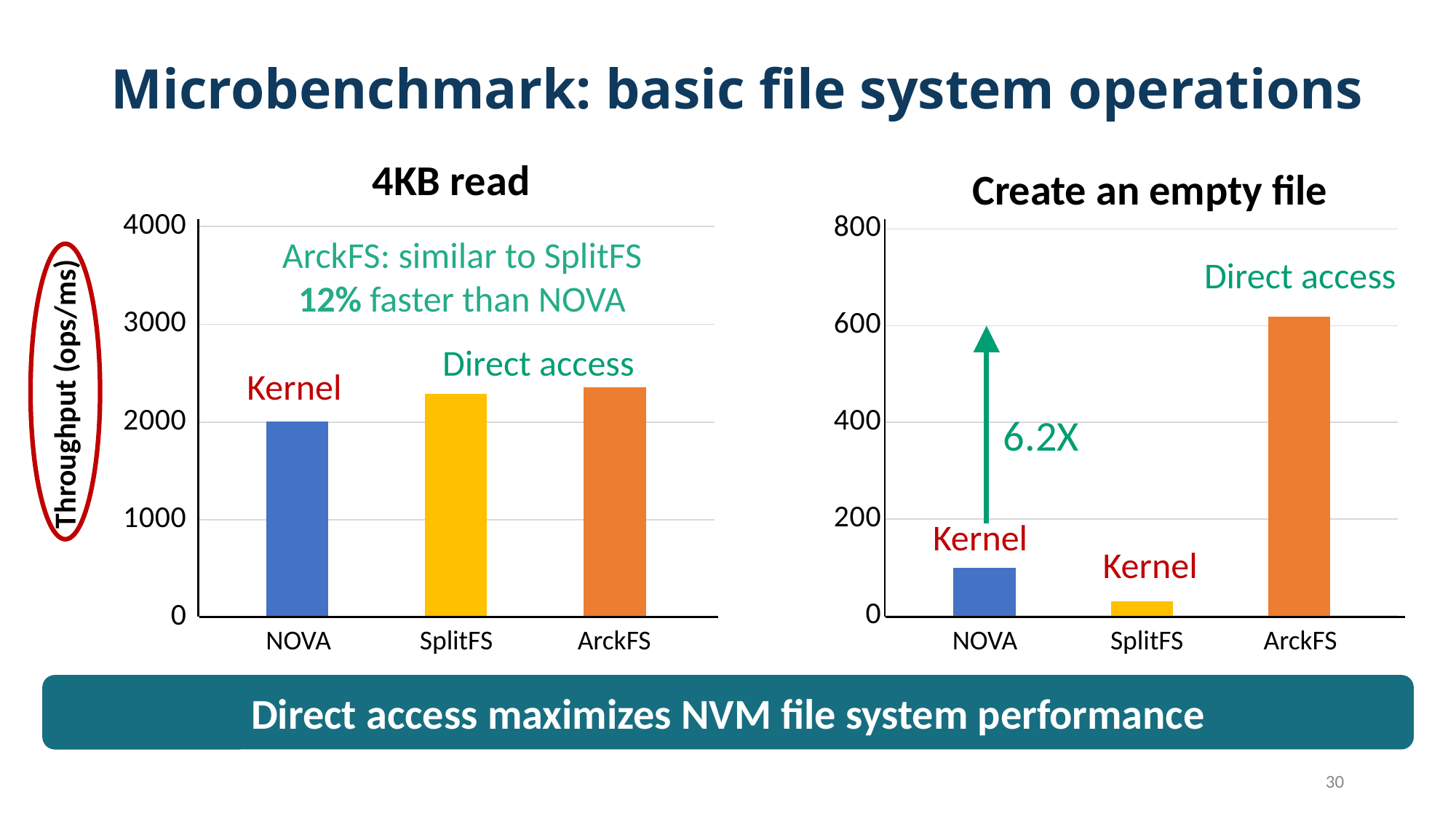
In the "Create an empty file" chart, which file system has the highest throughput? ArckFS In the "Create an empty file" chart, which is larger, the value for NOVA or the value for SplitFS? NOVA In the "4KB read" chart, is the value for SplitFS greater or less than 2000? greater In the "Create an empty file" chart, which file system has the lowest throughput? SplitFS In the "4KB read" chart, which is larger, the value for NOVA or the value for SplitFS? SplitFS What is the y-axis label shared by the two charts? Throughput (ops/ms) In the "Create an empty file" chart, is the value for ArckFS greater or less than 400? greater In the "4KB read" chart, is the value for ArckFS greater or less than 3000? less How many file systems are shown on the x axis of the "4KB read" chart? 3 In the "4KB read" chart, which file system has the lowest throughput? NOVA What kind of chart is the "4KB read" chart? bar chart